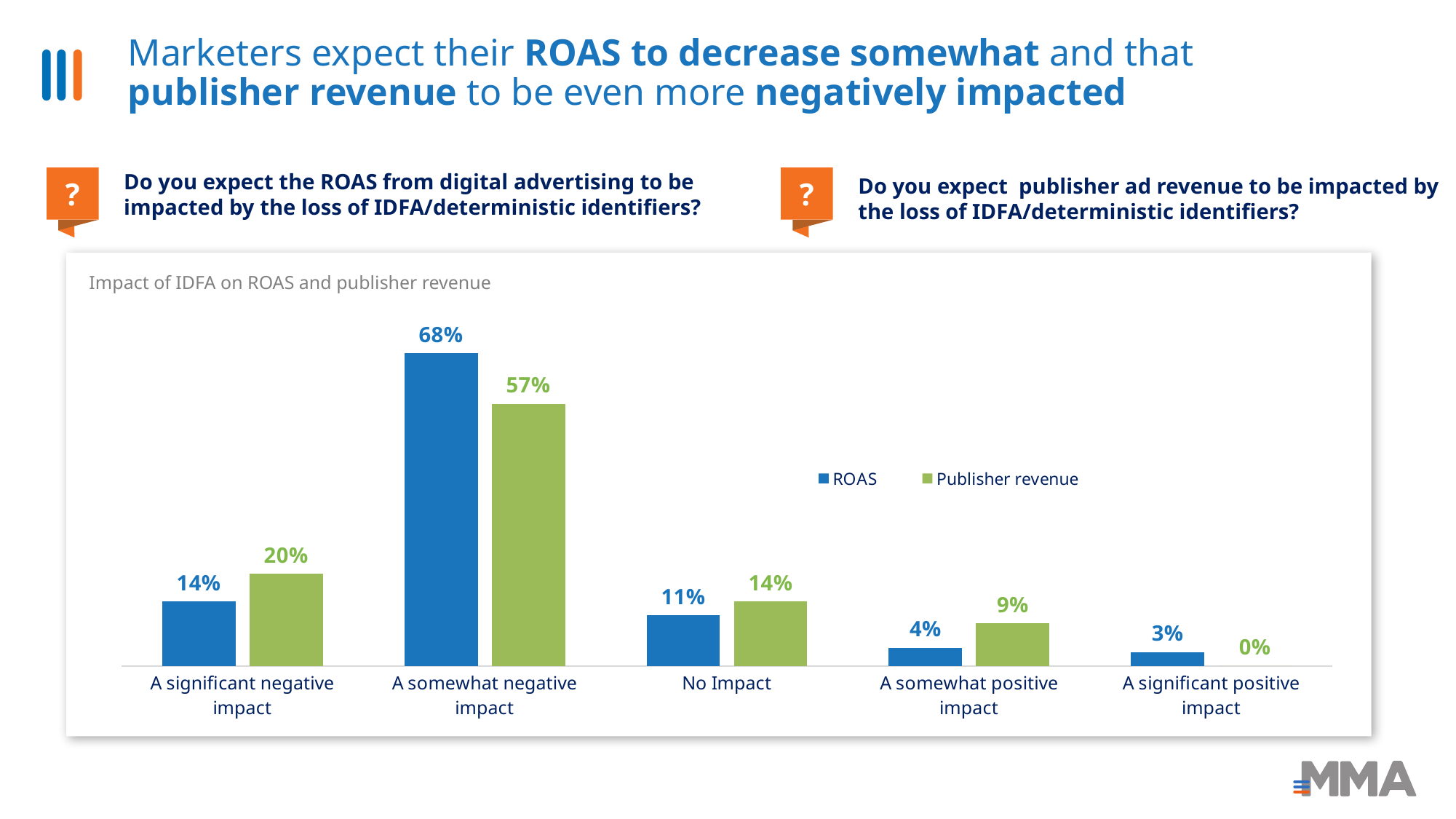
Which category has the lowest Publisher revenue value? A significant positive impact What is the difference between the ROAS and Publisher revenue values for 'A somewhat negative impact'? 11% Which is larger for 'A somewhat positive impact': ROAS or Publisher revenue? Publisher revenue What is the Publisher revenue value for 'A significant positive impact'? 0% What is the Publisher revenue value for 'A significant negative impact'? 20% Which category has the highest ROAS value? A somewhat negative impact What is the ROAS value for 'A somewhat negative impact'? 68% What is the title of the chart? Impact of IDFA on ROAS and publisher revenue What is the ROAS value for 'No Impact'? 11% What kind of chart is shown on the slide? Bar chart How many series does the legend list? 2 How many categories are shown on the x axis? 5